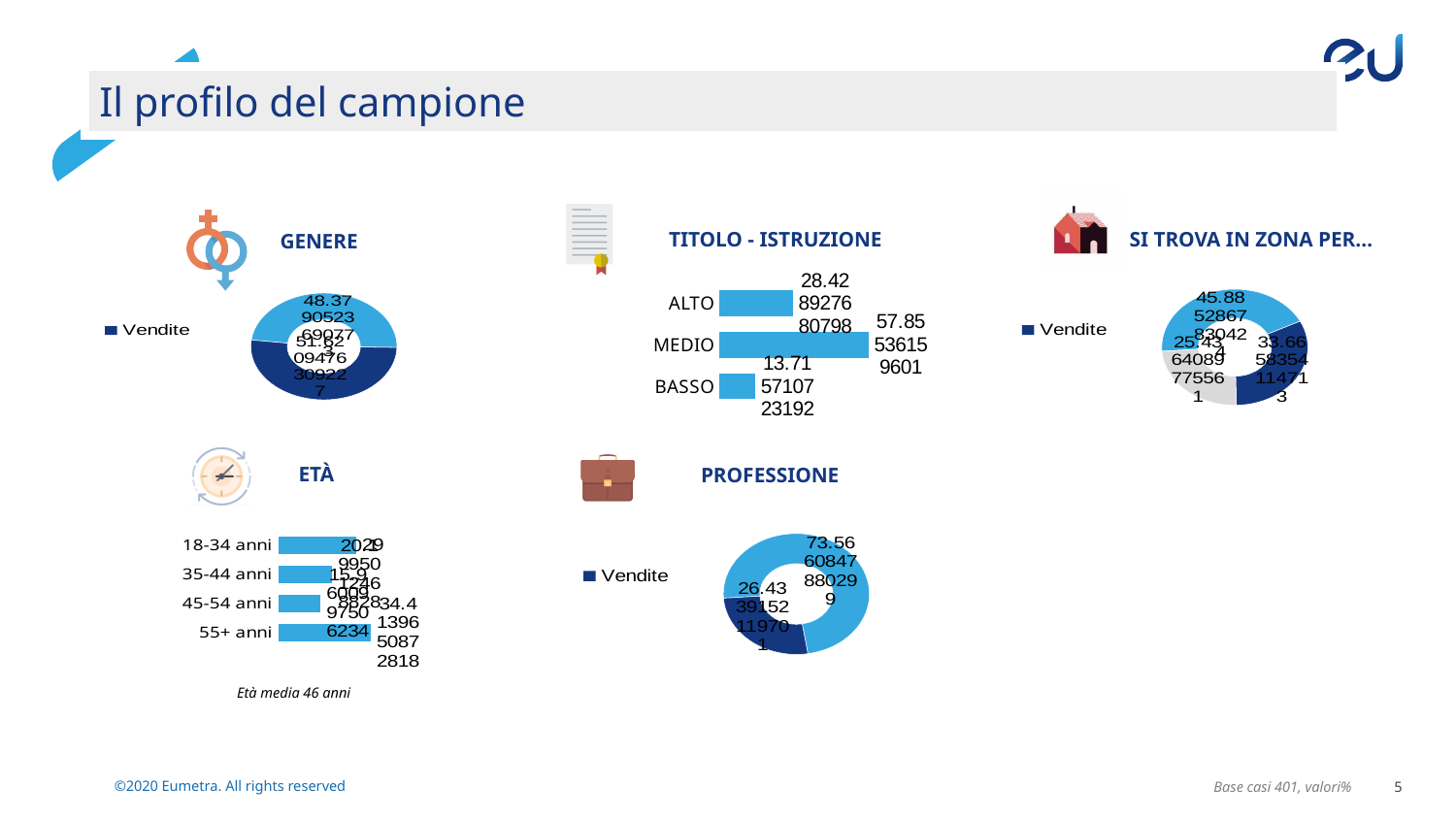
In the TITOLO - ISTRUZIONE chart, which is larger, ALTO or BASSO? ALTO In the TITOLO - ISTRUZIONE chart, which category has the lowest value? BASSO How many slices does the PROFESSIONE chart have? 2 What kind of chart is the ETÀ chart? Bar chart In the TITOLO - ISTRUZIONE chart, which category has the highest value? MEDIO How many categories are shown in the TITOLO - ISTRUZIONE chart? 3 How many series does the legend of the GENERE chart list? 1 What kind of chart is the GENERE chart? Doughnut chart How many age categories are shown in the ETÀ chart? 4 What kind of chart is the TITOLO - ISTRUZIONE chart? Bar chart What is the legend entry shown next to the PROFESSIONE chart? Vendite